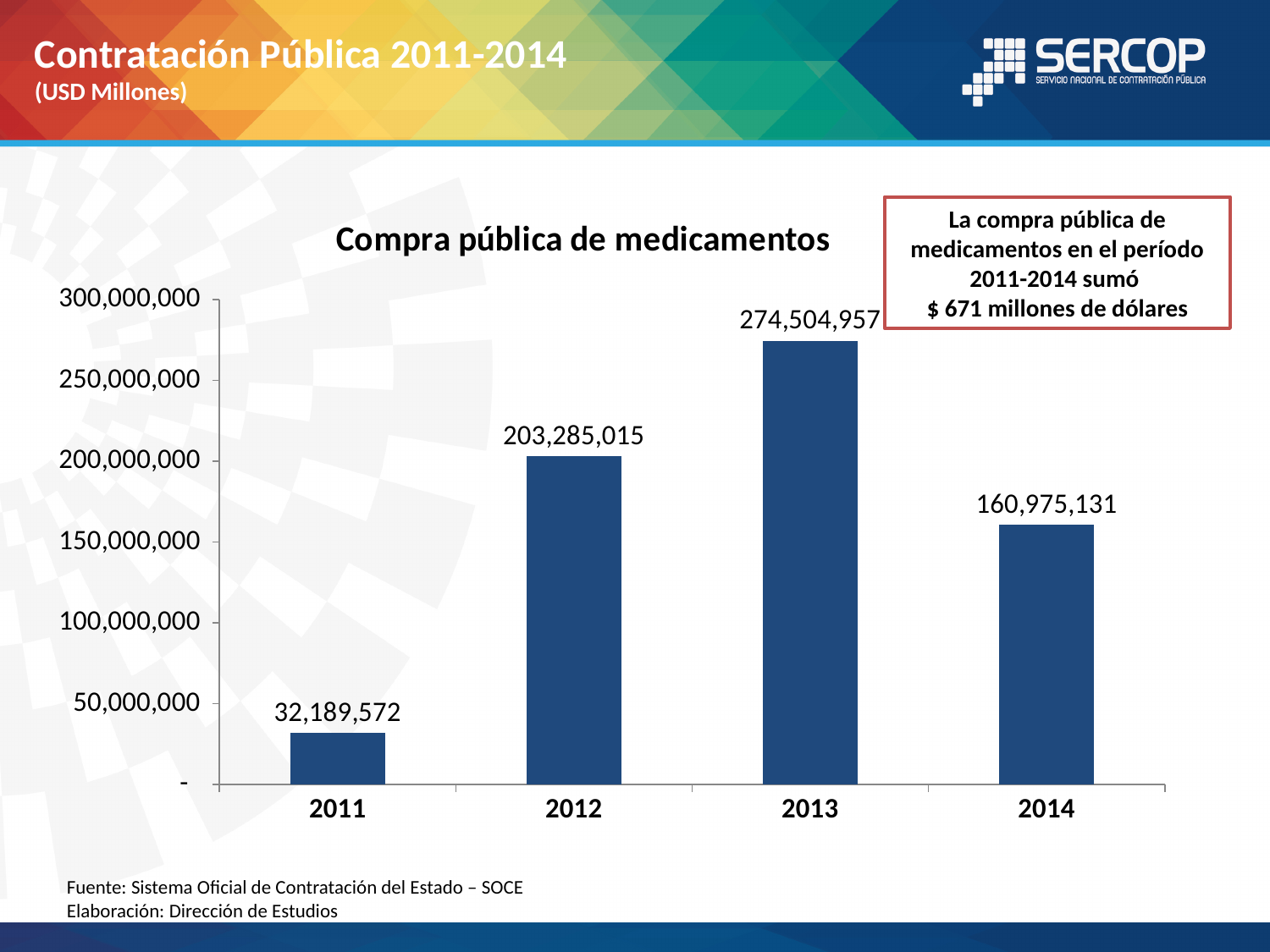
How many years are shown on the x axis of the chart? 4 Which year has the lowest value in the chart? 2011 Which is larger, the value for 2012 or the value for 2014? 2012 Do the values rise or fall from 2013 to 2014? fall What is the difference between the values for 2013 and 2012? 71,219,942 What is the difference between the values for 2012 and 2014? 42,309,884 What is the value for 2011 in the chart? 32,189,572 What is the value for 2014 in the chart? 160,975,131 Is the value for 2012 greater or less than 200,000,000? greater What kind of chart is shown on the slide? bar chart What is the value for 2013 in the chart? 274,504,957 Which year has the highest value in the chart? 2013